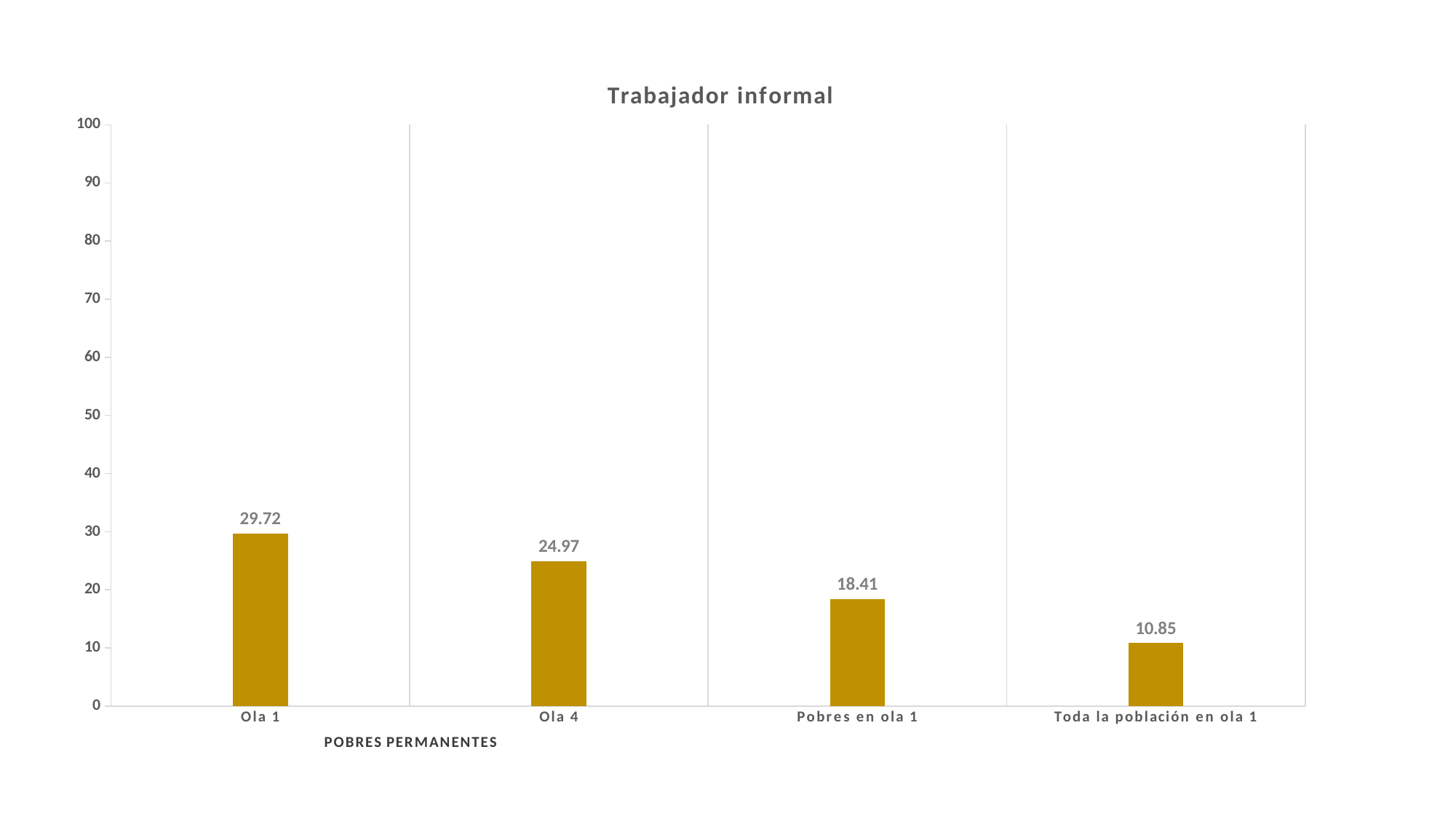
What is the value for Pobres en ola 1? 18.41 What is the value for Ola 1? 29.72 What is the difference between the values for Pobres en ola 1 and Toda la población en ola 1? 7.56 What is the title of the chart? Trabajador informal What kind of chart is this? Bar chart What is the value for Toda la población en ola 1? 10.85 What is the difference between the values for Ola 1 and Ola 4? 4.75 Which is larger, the value for Ola 4 or the value for Pobres en ola 1? Ola 4 How many categories are shown in the chart? 4 Which category has the highest value? Ola 1 Which category has the lowest value? Toda la población en ola 1 What is the value for Ola 4? 24.97